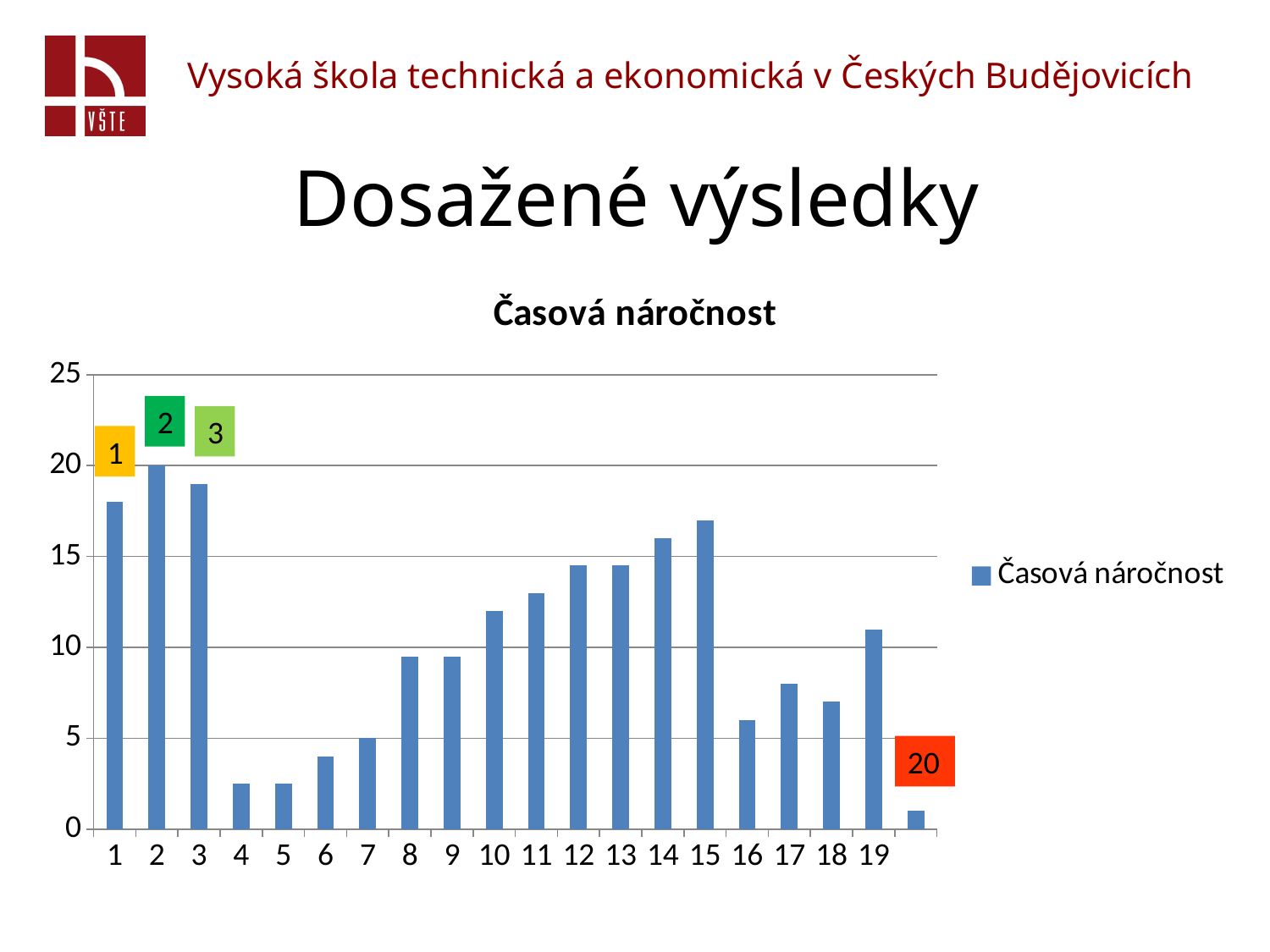
Which category has the lowest bar? 20 Is the value for category 19 greater or less than 10? greater Is the value for category 1 greater or less than 15? greater Which category has the highest bar? 2 Which is larger, the value for category 14 or the value for category 11? 14 What is the value for category 7? 5 What is the value for category 2? 20 How many series does the legend list? 1 How many bars are plotted in the chart? 20 What is the title of the chart? Časová náročnost Is the value for category 4 greater or less than 5? less What type of chart is shown on the slide? bar chart